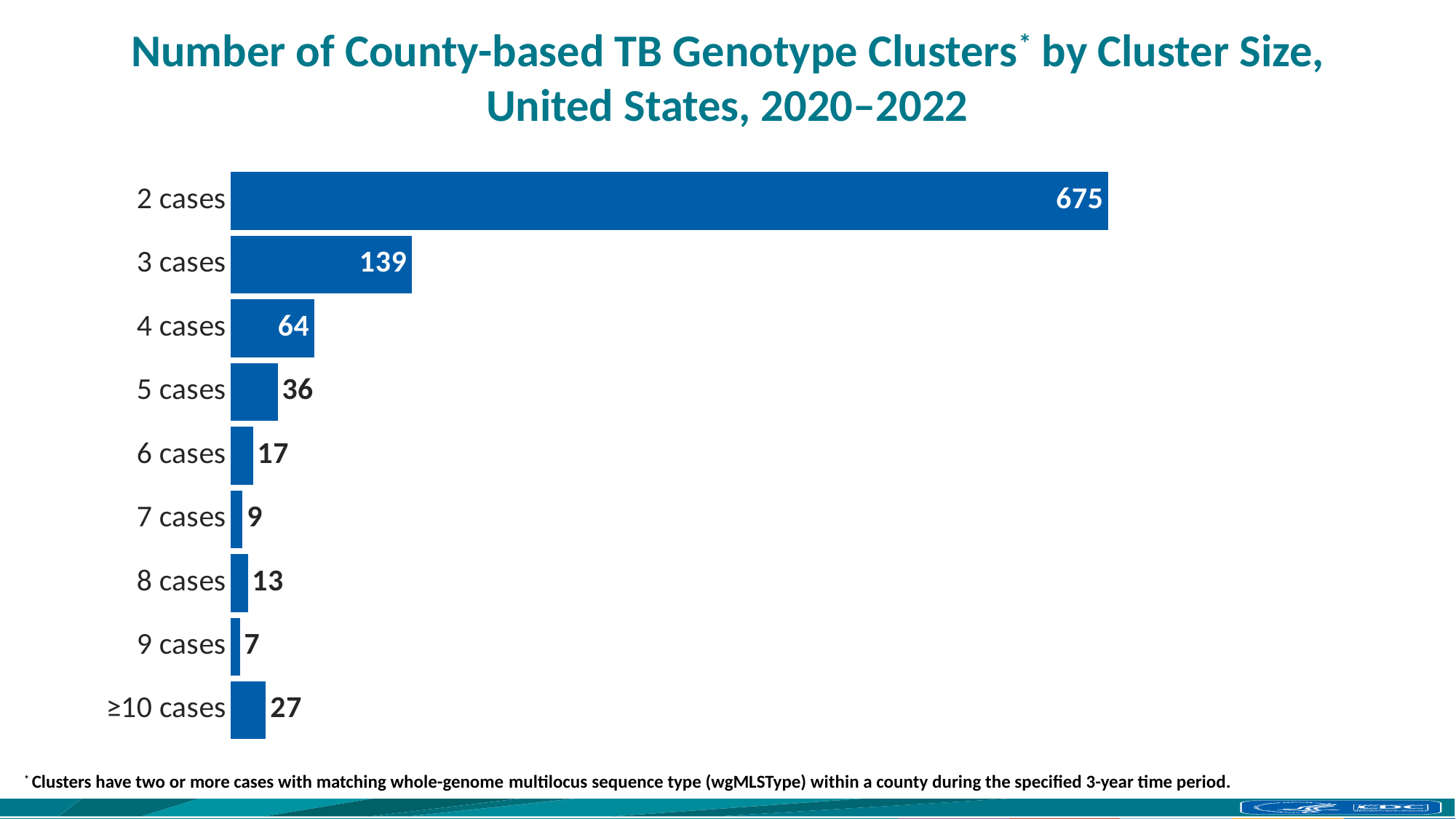
Which cluster size has the lowest number of clusters? 9 cases What is the number of clusters with 3 cases? 139 What kind of chart is shown on the slide? Bar chart Which has more clusters: 7 cases or 8 cases? 8 cases How many county-based TB genotype clusters had 2 cases? 675 What time period does the chart title cover? 2020–2022 What is the value shown for 6 cases? 17 What is the difference between the number of clusters with 2 cases and the number with 3 cases? 536 Which cluster size has the highest number of clusters? 2 cases How many clusters had ≥10 cases? 27 How many cluster-size categories are shown in the chart? 9 What is the difference between the number of clusters with 4 cases and with 5 cases? 28